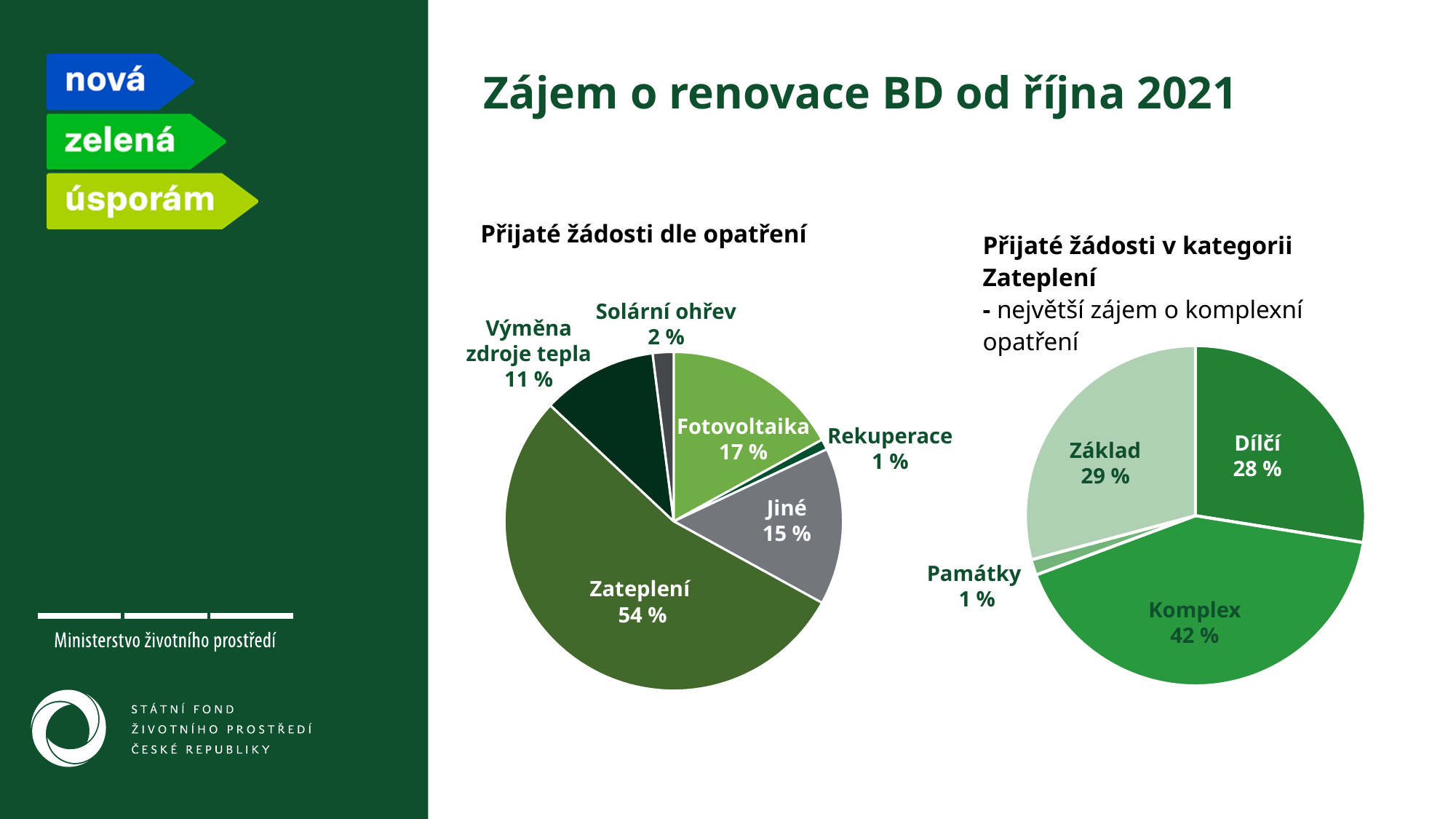
In the chart 'Přijaté žádosti dle opatření', which is larger: Výměna zdroje tepla or Solární ohřev? Výměna zdroje tepla In the chart 'Přijaté žádosti v kategorii Zateplení', what is the difference between the shares of Základ and Dílčí? 1 % In the chart 'Přijaté žádosti dle opatření', what share does Fotovoltaika have? 17 % In the chart 'Přijaté žádosti v kategorii Zateplení', how many categories are shown? 4 In the chart 'Přijaté žádosti dle opatření', how many categories are shown? 6 In the chart 'Přijaté žádosti dle opatření', what share does Zateplení have? 54 % In the chart 'Přijaté žádosti dle opatření', which category has the largest share? Zateplení In the chart 'Přijaté žádosti dle opatření', what is the difference between the shares of Fotovoltaika and Jiné? 2 % What type of chart is used for 'Přijaté žádosti v kategorii Zateplení'? Pie chart In the chart 'Přijaté žádosti v kategorii Zateplení', which category has the largest share? Komplex In the chart 'Přijaté žádosti v kategorii Zateplení', what share does Komplex have? 42 % In the chart 'Přijaté žádosti dle opatření', which category has the smallest share? Rekuperace